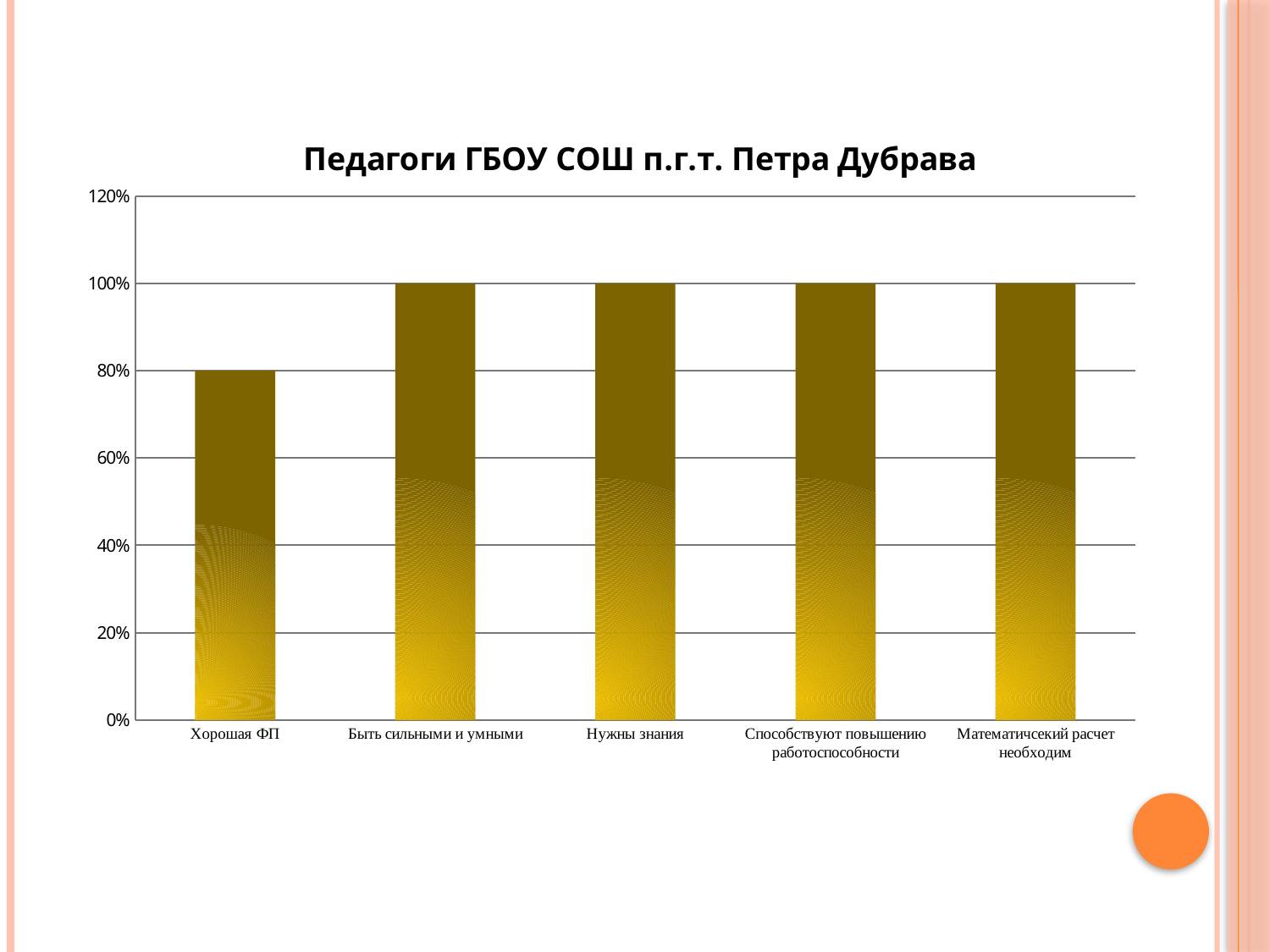
How many categories are shown on the x axis of the chart? 5 What is the value for "Математичсекий расчет необходим"? 100% What is the value for "Хорошая ФП"? 80% What kind of chart is shown on the slide? bar chart What is the value for "Быть сильными и умными"? 100% What is the title of the chart? Педагоги ГБОУ СОШ п.г.т. Петра Дубрава What is the highest value reached by any bar in the chart? 100% Is the value for "Хорошая ФП" greater or less than 60%? greater Which is larger, the value for "Хорошая ФП" or the value for "Нужны знания"? Нужны знания What is the difference between the values for "Способствуют повышению работоспособности" and "Хорошая ФП"? 20% What is the value for "Нужны знания"? 100% Which category has the lowest value? Хорошая ФП